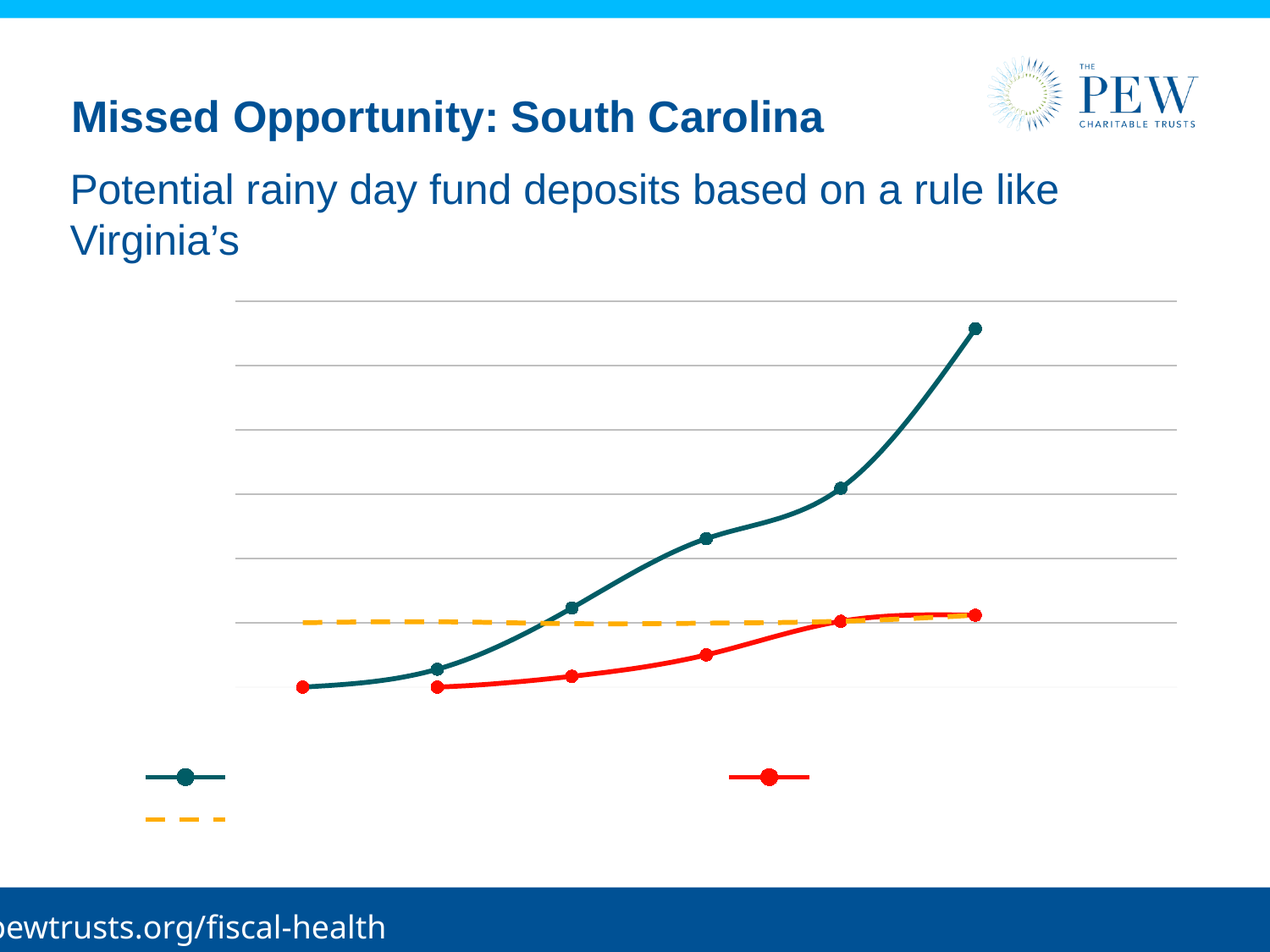
At the rightmost point, which line is higher: the teal line or the red line? teal line Does the teal line rise or fall from left to right? rise How many series does the legend list? 3 How many data points are plotted on the teal line? 6 Is the orange dashed line rising, falling, or roughly flat across the chart? roughly flat How many of the plotted lines have circular markers? 2 At the third point from the left, which line is higher: the teal line or the red line? teal line Which series in the legend is drawn as a dashed line? the orange one How many data points are plotted on the red line? 6 Does the red line rise or fall from left to right? rise Which series reaches the highest point on the chart? the teal line What kind of chart is shown on the slide? line chart